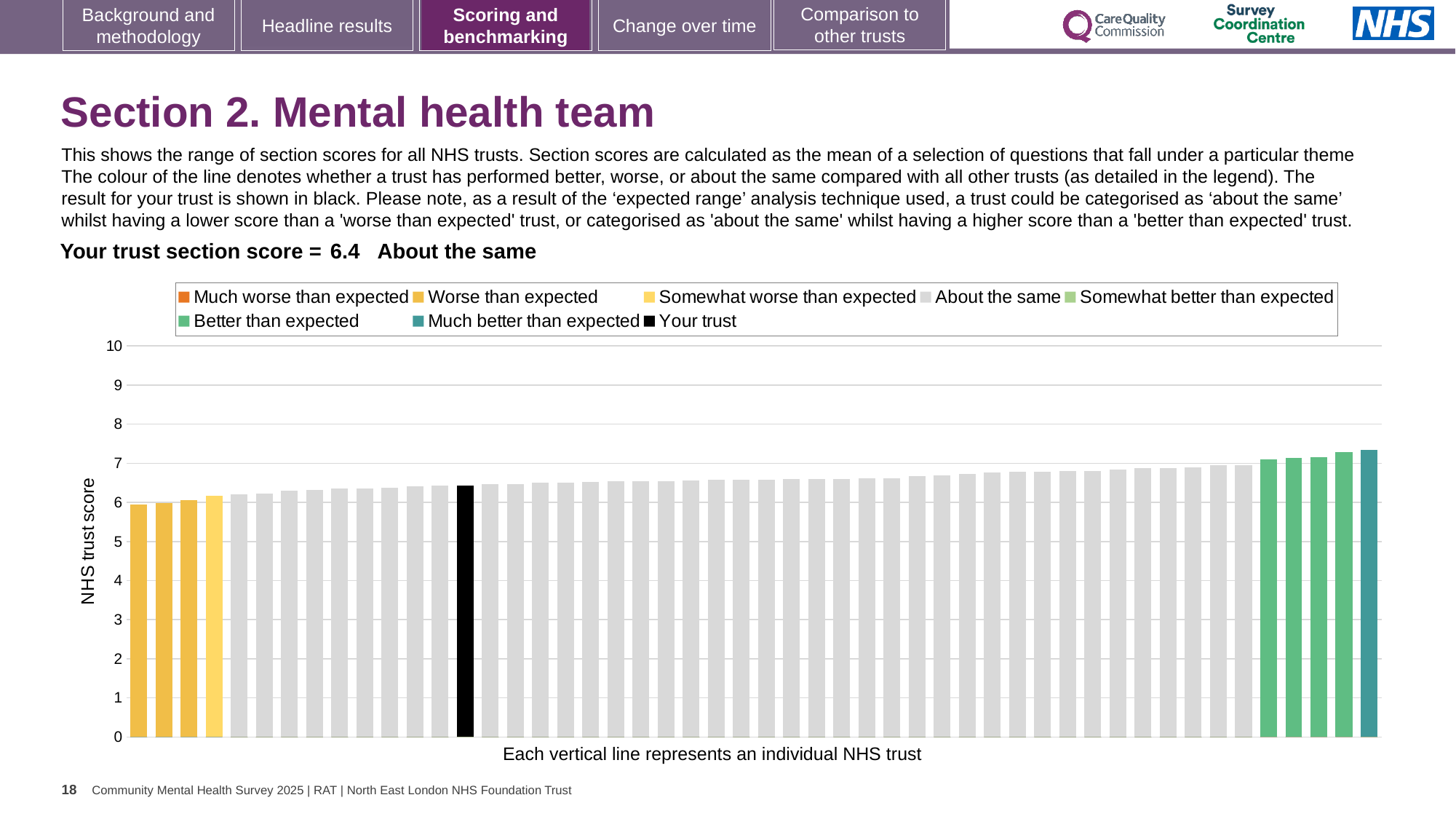
Do the bar values rise or fall from left to right along the x axis? rise How many bars are coloured as 'Much worse than expected'? 0 What colour is the bar representing your trust? black Which legend category does the tallest bar belong to? Much better than expected Is the value of the tallest bar greater or less than 7? greater What is the section score for your trust shown on the slide? 6.4 What kind of chart is shown on the slide? bar chart What is the label on the vertical axis of the chart? NHS trust score Is the value of the shortest bar greater or less than 5? greater Which legend category does the shortest bar belong to? Worse than expected How many entries does the chart legend list? 8 Is the value of the bar for your trust greater or less than 5? greater